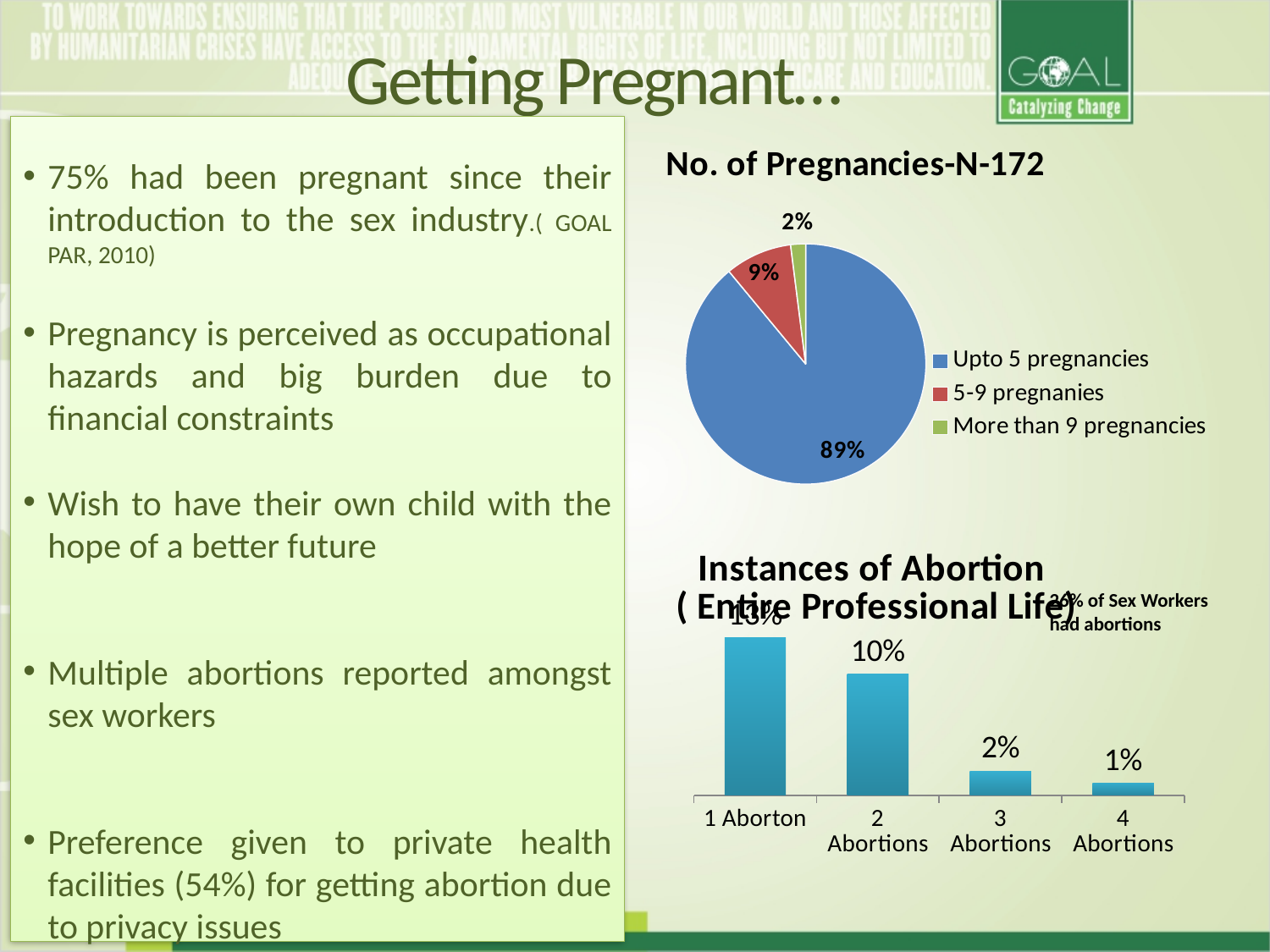
In the 'No. of Pregnancies-N-172' pie chart, which category has the largest slice? Upto 5 pregnancies What kind of chart is the 'No. of Pregnancies-N-172' chart? Pie chart In the 'Instances of Abortion (Entire Professional Life)' bar chart, what is the difference between the values for '2 Abortions' and '3 Abortions'? 8% In the 'No. of Pregnancies-N-172' pie chart, what share is labelled for 'More than 9 pregnancies'? 2% How many categories does the legend of the 'No. of Pregnancies-N-172' pie chart list? 3 In the 'Instances of Abortion (Entire Professional Life)' bar chart, which category has the tallest bar? 1 Aborton In the 'No. of Pregnancies-N-172' pie chart, what share is labelled for '5-9 pregnanies'? 9% In the 'Instances of Abortion (Entire Professional Life)' bar chart, what is the value for '4 Abortions'? 1% What kind of chart is the 'Instances of Abortion (Entire Professional Life)' chart? Bar chart In the 'No. of Pregnancies-N-172' pie chart, what share is labelled for 'Upto 5 pregnancies'? 89% In the 'Instances of Abortion (Entire Professional Life)' bar chart, what is the value for '2 Abortions'? 10% In the 'No. of Pregnancies-N-172' pie chart, which category has the smallest slice? More than 9 pregnancies